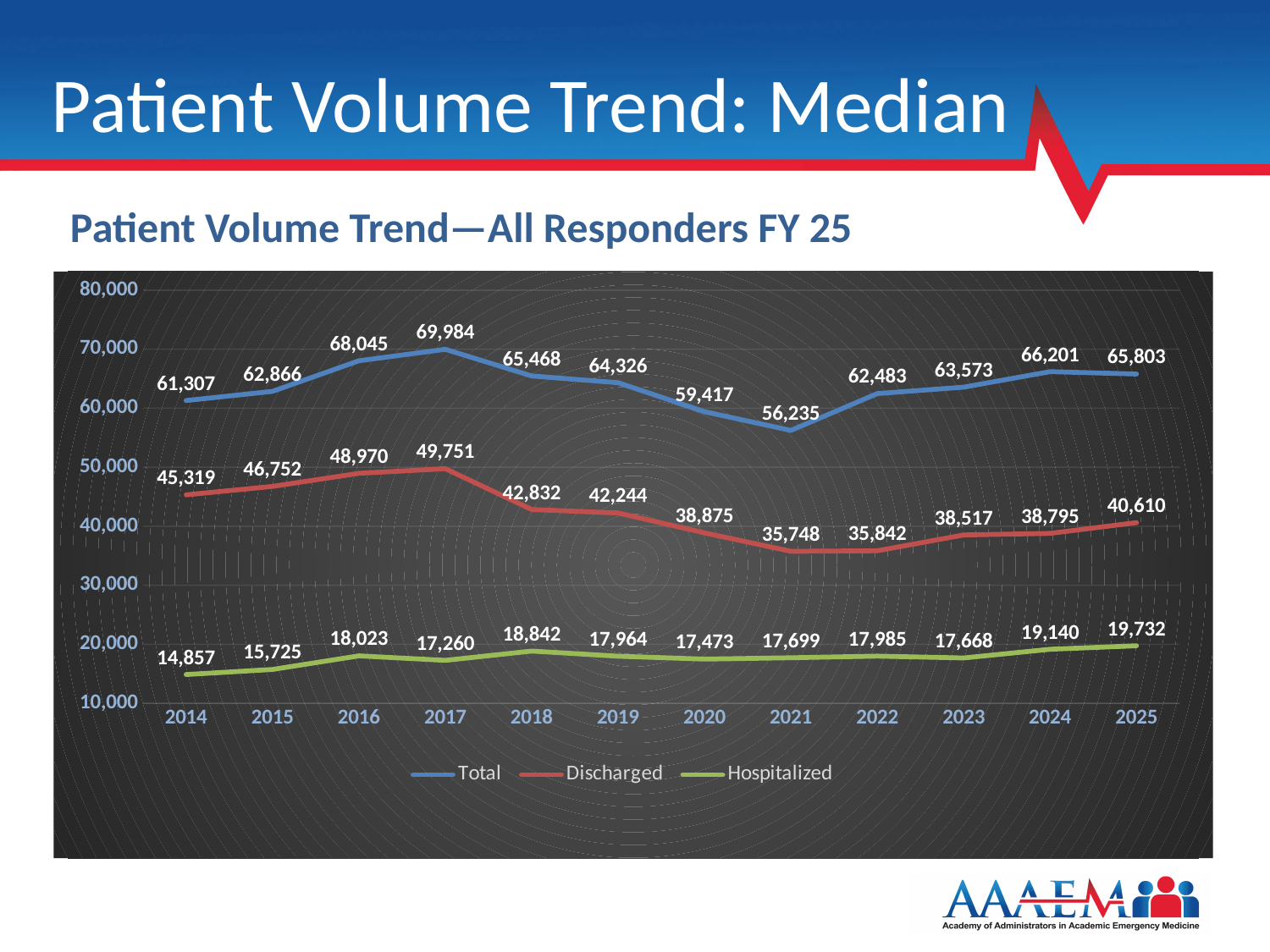
Which is larger, the Total value for 2024 or for 2025? 2024 In which year is the Hospitalized series at its lowest? 2014 How many series does the legend list? 3 What is the Discharged value for 2021? 35,748 In which year is the Total series at its lowest? 2021 What is the Total patient volume for 2017? 69,984 Is the Total value for 2021 greater or less than 60,000? less In which year is the Total series at its highest? 2017 What is the difference between the Discharged values for 2017 and 2014? 4,432 What kind of chart is shown on the slide? line chart What is the Hospitalized value for 2025? 19,732 How many years are shown on the x axis? 12